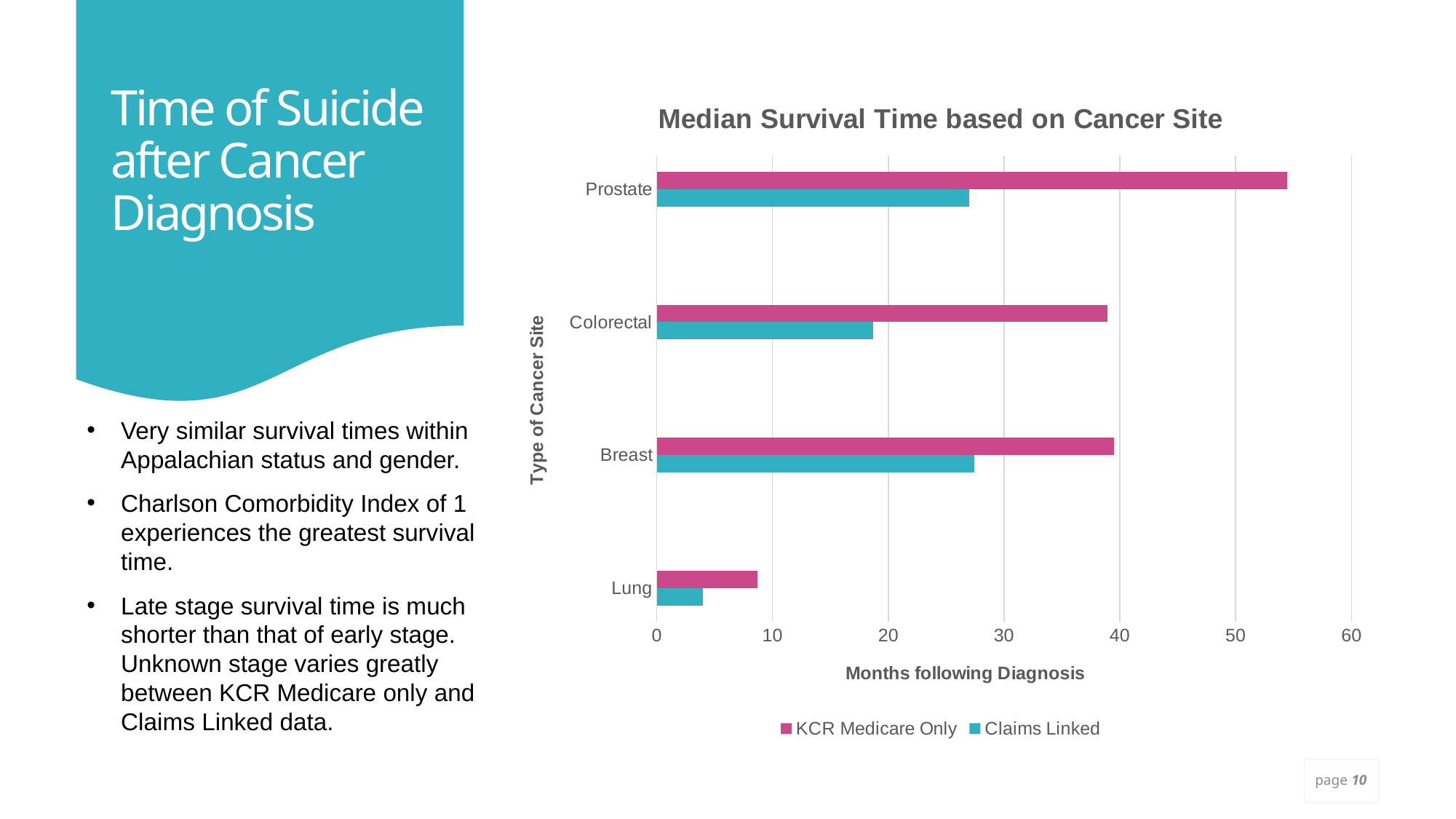
What type of chart is shown on the slide? bar chart What is the label of the x axis? Months following Diagnosis How many cancer sites are shown on the chart? 4 Which cancer site has the lowest Claims Linked median survival time? Lung Is the KCR Medicare Only value for Prostate greater or less than 50? greater How many series does the legend list? 2 Which cancer site has the lowest KCR Medicare Only median survival time? Lung Is the Claims Linked value for Prostate greater or less than 30? less What is the title of the chart? Median Survival Time based on Cancer Site Is the KCR Medicare Only value for Lung greater or less than 10? less Which is larger for Prostate: the KCR Medicare Only value or the Claims Linked value? KCR Medicare Only Which cancer site has the highest KCR Medicare Only median survival time? Prostate